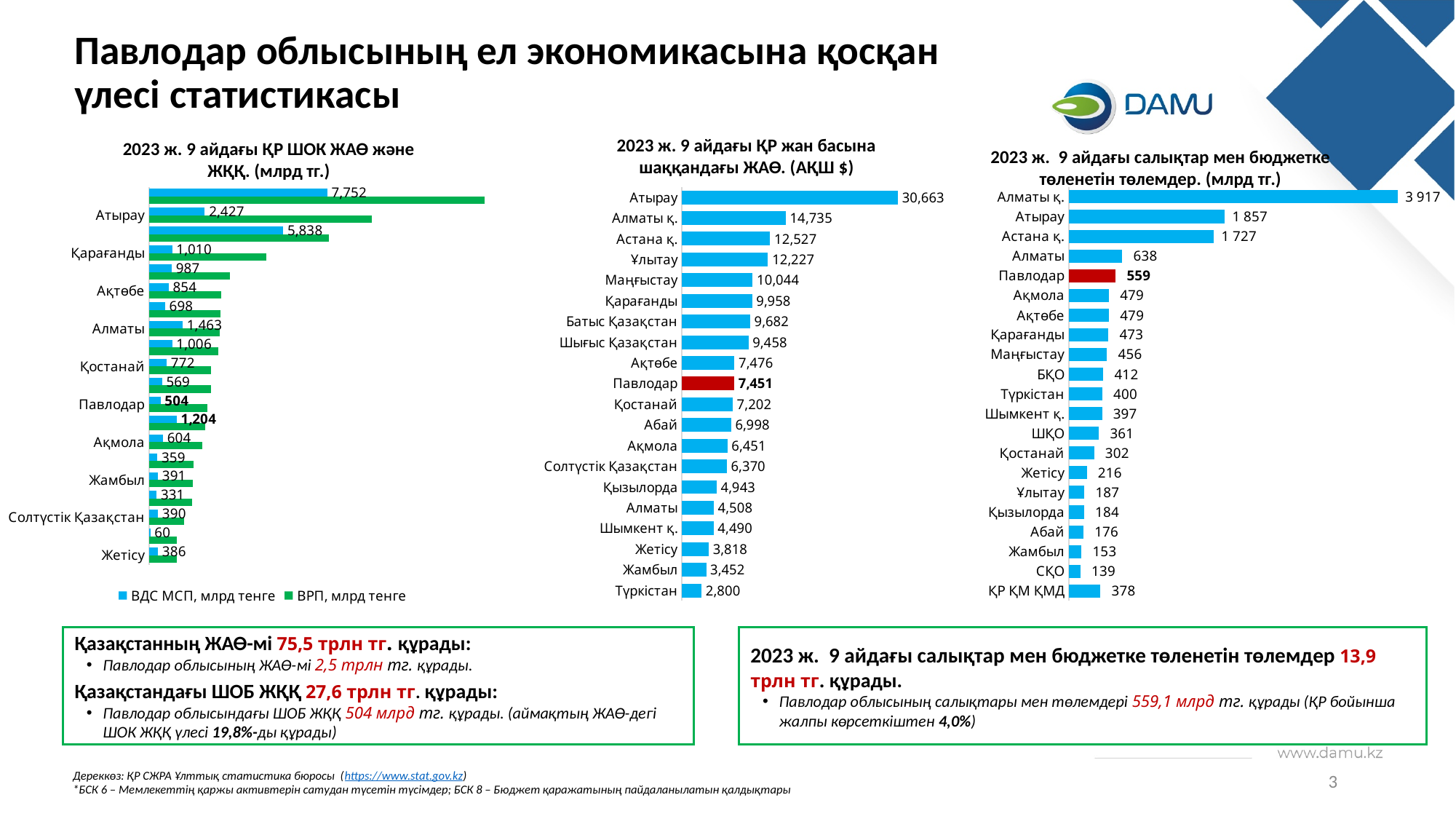
What type of chart is the middle chart (ҚР жан басына шаққандағы ЖАӨ)? Bar chart In the middle chart (2023 ж. 9 айдағы ҚР жан басына шаққандағы ЖАӨ), what is the value for Павлодар? 7,451 In the right chart (салықтар мен бюджетке төленетін төлемдер), what is the value for Павлодар? 559 In the middle chart (ҚР жан басына шаққандағы ЖАӨ), which region has the highest value? Атырау How many categories are shown in the right chart (салықтар мен бюджетке төленетін төлемдер)? 21 In the right chart (салықтар мен бюджетке төленетін төлемдер), which is larger: Атырау or Астана қ.? Атырау In the right chart (салықтар мен бюджетке төленетін төлемдер), which category has the highest value? Алматы қ. In the middle chart (ҚР жан басына шаққандағы ЖАӨ), which region has the lowest value? Түркістан How many series does the legend of the left chart (ҚР ШОК ЖАӨ және ЖҚҚ) list? 2 How many regions are shown in the middle chart (ҚР жан басына шаққандағы ЖАӨ)? 20 In the middle chart (ҚР жан басына шаққандағы ЖАӨ), what is the difference between Атырау and Алматы қ.? 15,928 In the right chart (салықтар мен бюджетке төленетін төлемдер), what is the difference between Алматы қ. and Атырау? 2 060